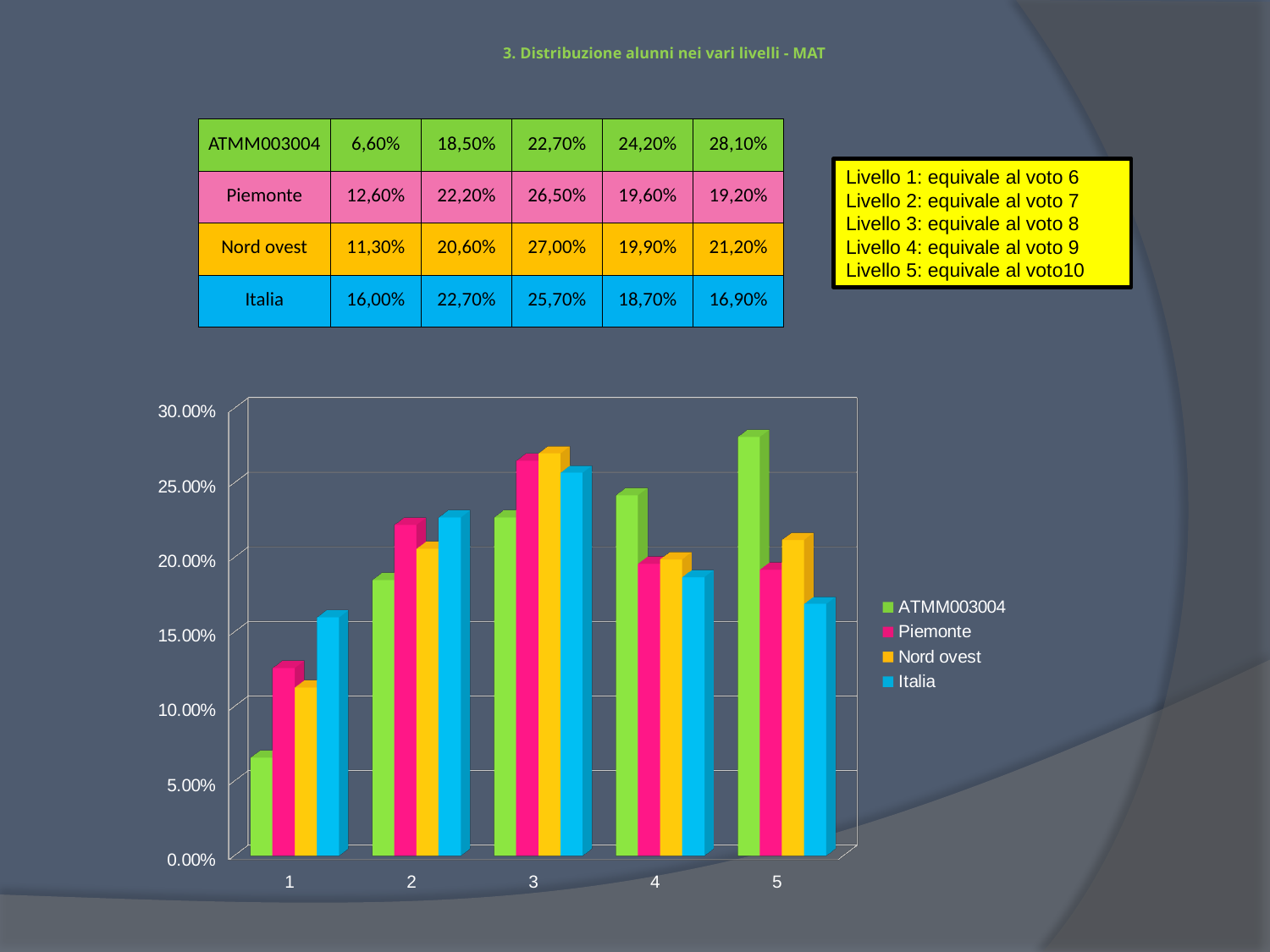
What is the difference between the Piemonte and ATMM003004 values at level 1? 6,00% Do the values for ATMM003004 rise or fall from level 1 to level 5? rise Which series has the lowest value at level 1? ATMM003004 Which series has the highest value at level 5? ATMM003004 What kind of chart is shown on the slide? bar chart According to the table, what is the value for ATMM003004 at level 5? 28,10% According to the table, what is the value for Nord ovest at level 3? 27,00% Which is larger at level 4: the value for ATMM003004 or the value for Italia? ATMM003004 Is the value for ATMM003004 at level 5 greater or less than 25.00%? greater How many series does the chart legend list? 4 According to the table, what is the value for Italia at level 1? 16,00% How many categories are shown on the x axis of the chart? 5